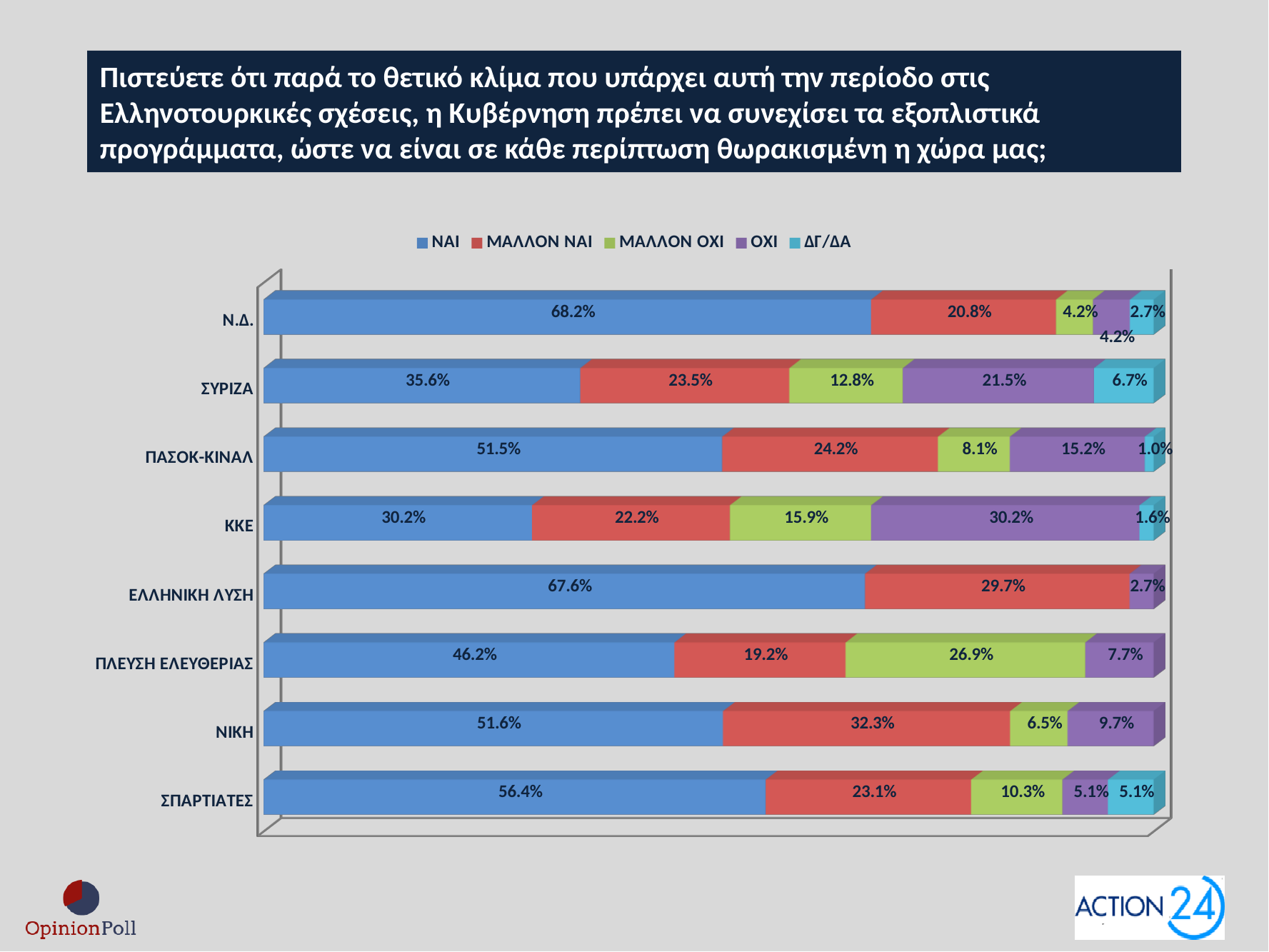
Which is larger for ΠΑΣΟΚ-ΚΙΝΑΛ: the ΜΑΛΛΟΝ ΝΑΙ value or the ΟΧΙ value? ΜΑΛΛΟΝ ΝΑΙ Which party has the highest ΜΑΛΛΟΝ ΝΑΙ percentage? ΝΙΚΗ What is the ΜΑΛΛΟΝ ΟΧΙ value for ΠΛΕΥΣΗ ΕΛΕΥΘΕΡΙΑΣ? 26.9% What is the difference between the ΝΑΙ value for Ν.Δ. and the ΝΑΙ value for ΣΥΡΙΖΑ? 32.6 percentage points Which party has the highest ΝΑΙ percentage? Ν.Δ. How many series does the legend list? 5 What is the ΔΓ/ΔΑ value for ΣΥΡΙΖΑ? 6.7% What kind of chart is shown on the slide? Stacked bar chart How many parties are shown on the chart? 8 Which party has the lowest ΝΑΙ percentage? ΚΚΕ What is the ΟΧΙ value for ΚΚΕ? 30.2% What percentage of Ν.Δ. respondents answered ΝΑΙ? 68.2%